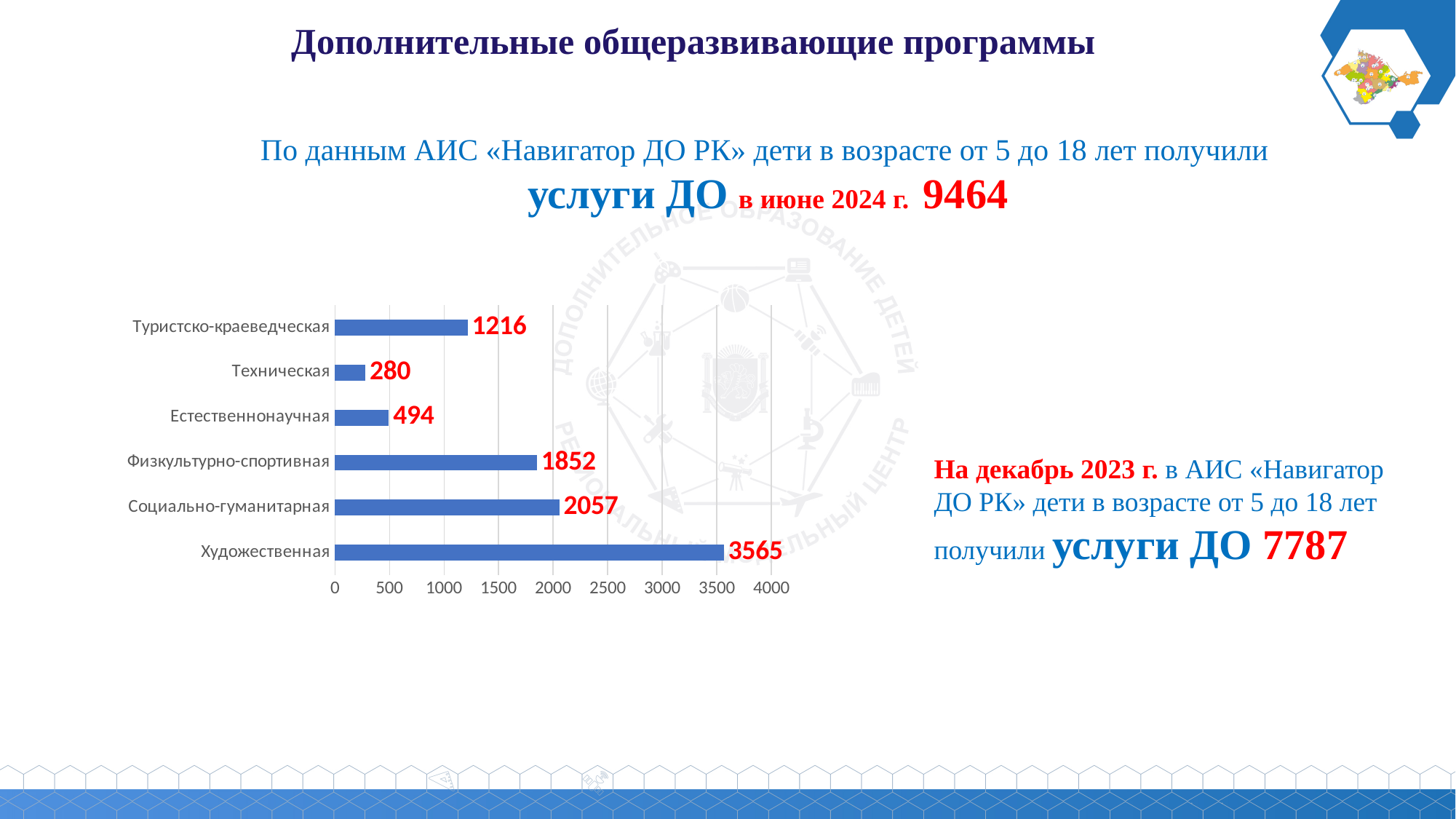
How many categories are shown in the chart? 6 Is the value for Туристско-краеведческая greater or less than 1000? greater What kind of chart is shown on the slide? bar chart What is the value for Техническая? 280 What is the difference between the values for Художественная and Социально-гуманитарная? 1508 What is the value for Физкультурно-спортивная? 1852 Which category has the lowest value? Техническая Which is larger, the value for Социально-гуманитарная or the value for Физкультурно-спортивная? Социально-гуманитарная What is the difference between the values for Естественнонаучная and Техническая? 214 Which category has the highest value? Художественная What is the value for Художественная? 3565 What is the value for Туристско-краеведческая? 1216